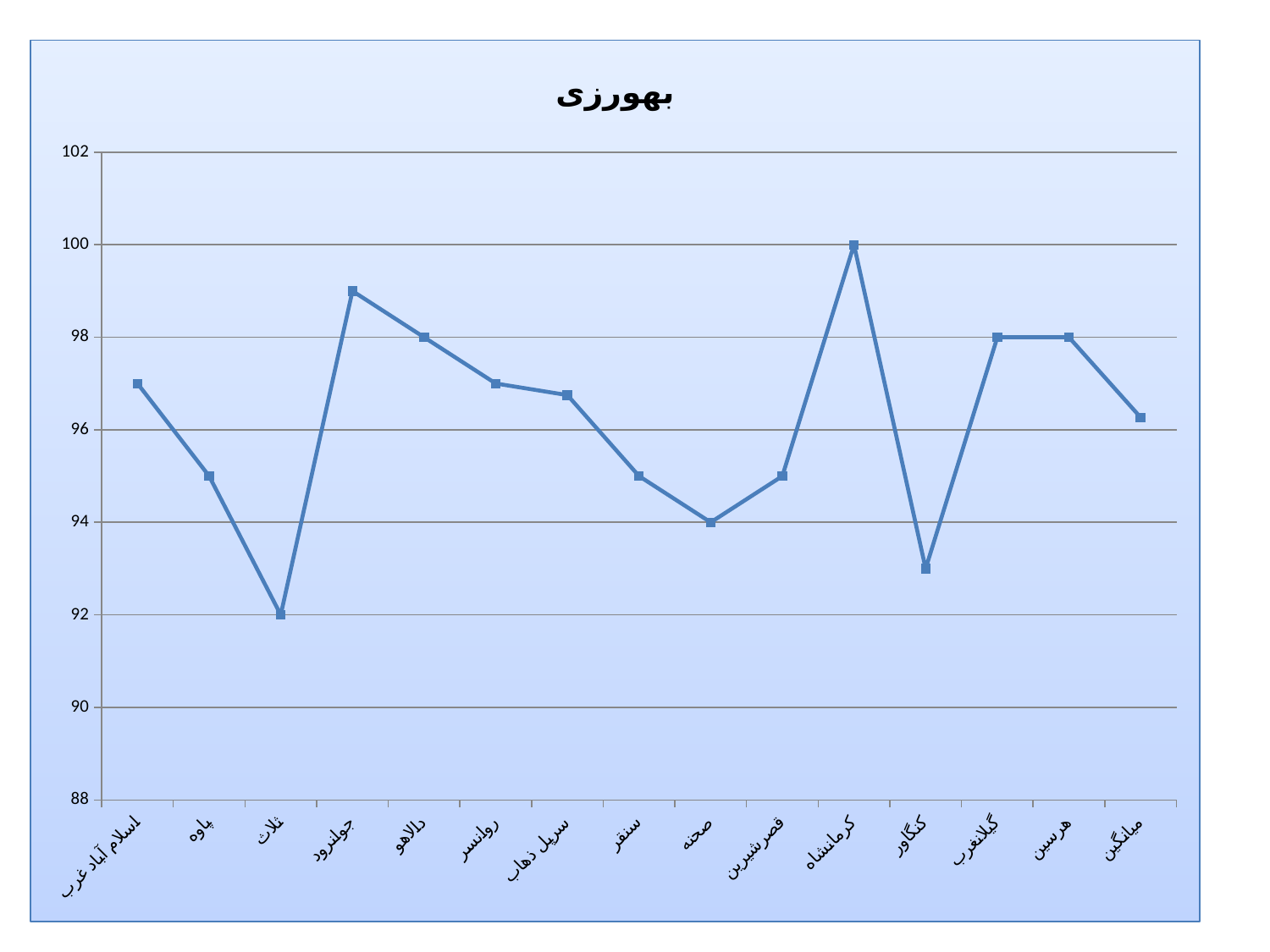
Is the value for کنگاور greater or less than 94? less What is the value for کرمانشاه? 100 Is the value for جوانرود greater or less than 98? greater What is the value for صحنه? 94 Which category has the lowest value? ثلاث What is the difference between the values for کرمانشاه and ثلاث? 8 What is the title of the chart? بهورزی Which category has the highest value? کرمانشاه Which has the larger value, جوانرود or دالاهو? جوانرود What is the value for ثلاث? 92 How many categories are plotted along the x axis? 15 What kind of chart is shown on the slide? line chart